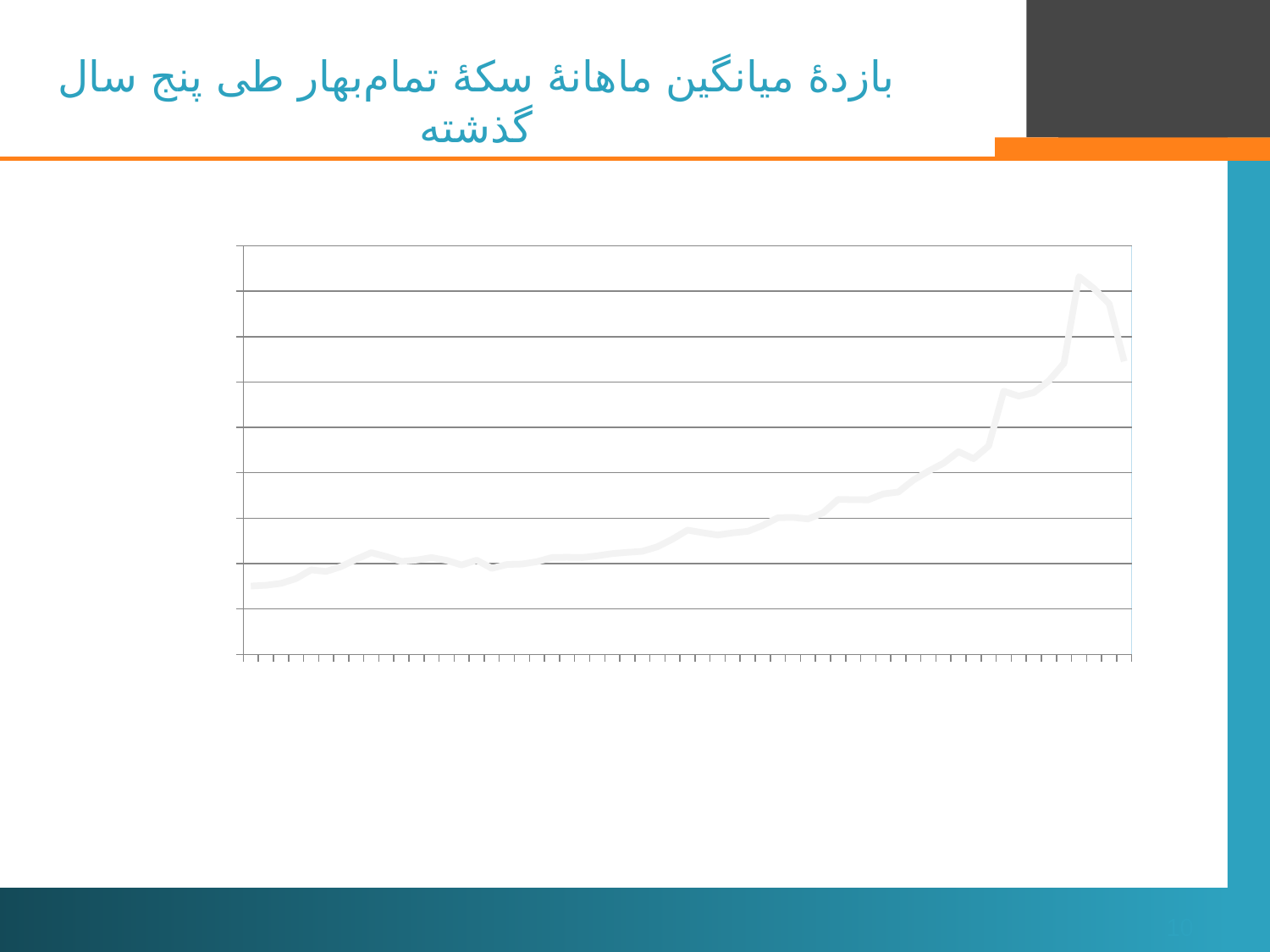
Is the highest point of the line located near the left end or near the right end of the chart? near the right end What is the title of the slide above the chart? بازدۀ میانگین ماهانۀ سکۀ تمام‌بهار طی پنج سال گذشته Does the chart display a legend? No How many lines are plotted on the chart? 1 Overall, does the line rise or fall from left to right across the chart? rise Is the lowest point of the line located near the left end or near the right end of the chart? near the left end Does the line fall or rise over its last few points at the right end of the chart? fall What kind of chart is shown on the slide? line chart